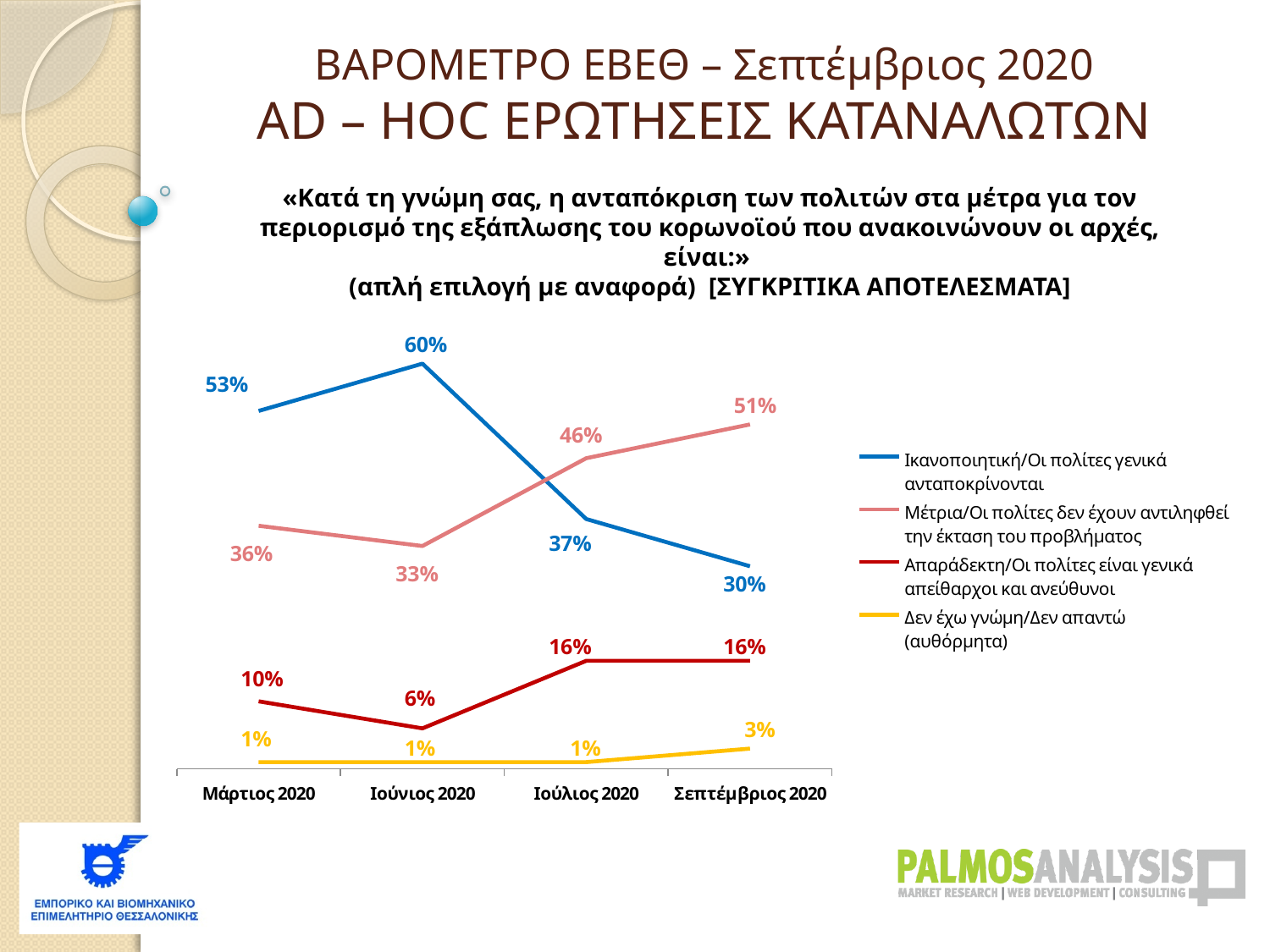
What is the value for Απαράδεκτη/Οι πολίτες είναι γενικά απείθαρχοι και ανεύθυνοι in Μάρτιος 2020? 10% How many time points are shown on the x axis? 4 In Σεπτέμβριος 2020, which is larger: the Ικανοποιητική series or the Μέτρια series? Μέτρια/Οι πολίτες δεν έχουν αντιληφθεί την έκταση του προβλήματος In which month is the Ικανοποιητική/Οι πολίτες γενικά ανταποκρίνονται series at its highest? Ιούνιος 2020 What is the value for Δεν έχω γνώμη/Δεν απαντώ (αυθόρμητα) in Σεπτέμβριος 2020? 3% Does the Ικανοποιητική/Οι πολίτες γενικά ανταποκρίνονται series rise or fall from Ιούνιος 2020 to Σεπτέμβριος 2020? fall What is the difference between the Ικανοποιητική series value in Ιούνιος 2020 and its value in Σεπτέμβριος 2020? 30% What type of chart is shown on the slide? line chart What is the value for Ικανοποιητική/Οι πολίτες γενικά ανταποκρίνονται in Ιούνιος 2020? 60% How many series does the legend list? 4 What is the value for Μέτρια/Οι πολίτες δεν έχουν αντιληφθεί την έκταση του προβλήματος in Σεπτέμβριος 2020? 51% In which month is the Μέτρια/Οι πολίτες δεν έχουν αντιληφθεί την έκταση του προβλήματος series at its lowest? Ιούνιος 2020